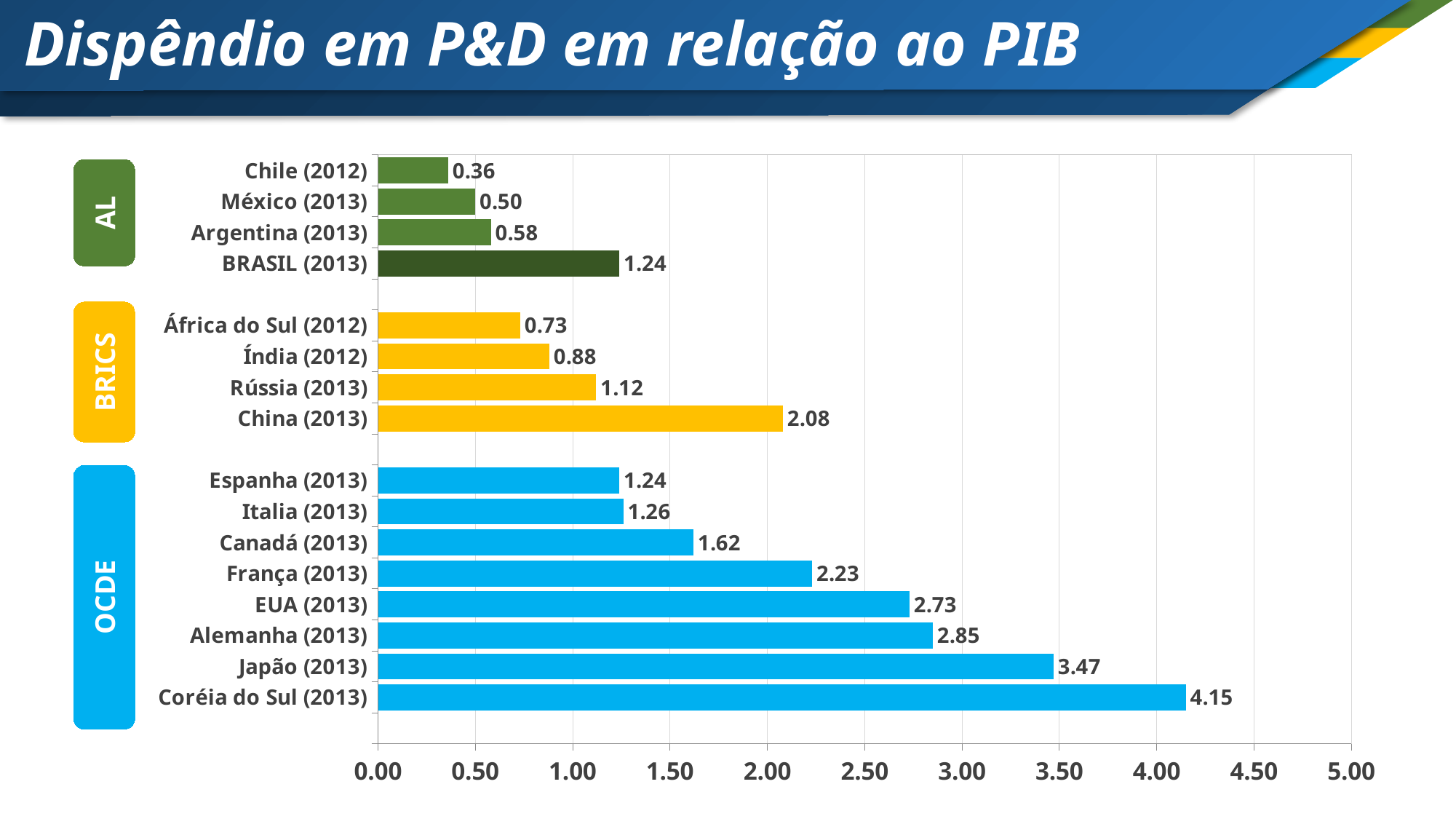
What is the difference between the values for China (2013) and BRASIL (2013)? 0.84 What is the value for China (2013)? 2.08 What type of chart is shown on the slide? bar chart How many countries are in the OCDE group of the chart? 8 What is the value for BRASIL (2013)? 1.24 What is the difference between the values for Coréia do Sul (2013) and Japão (2013)? 0.68 What is the value for Japão (2013)? 3.47 How many countries are shown in the chart? 16 Which has a larger value, Alemanha (2013) or EUA (2013)? Alemanha (2013) Which country has the lowest value in the chart? Chile (2012) Is the value for França (2013) greater or less than 2.00? greater Which country has the highest value in the chart? Coréia do Sul (2013)